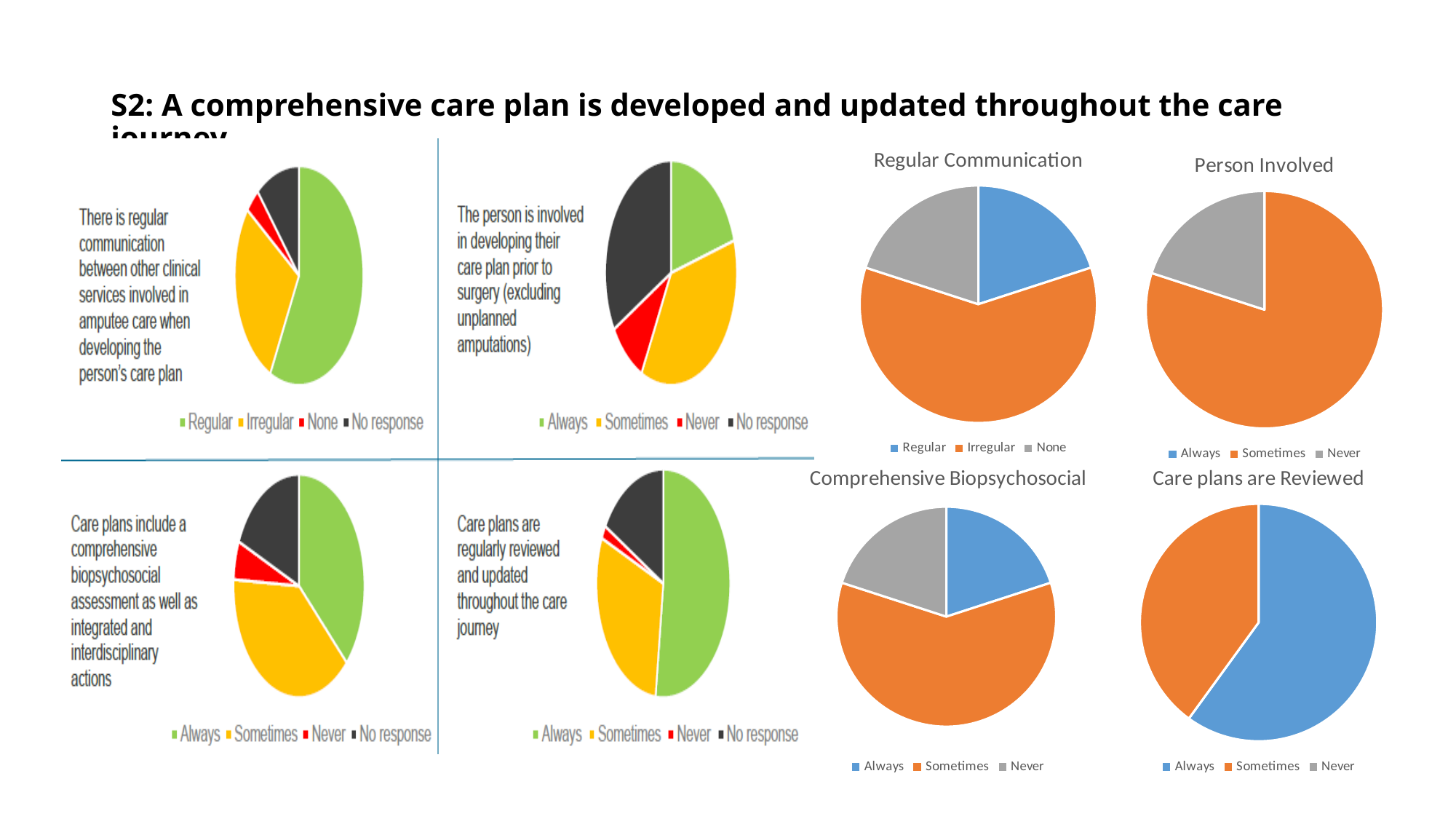
How many categories does the legend of the top-right pie chart about the person being involved in developing their care plan list? 4 What type of chart is the "Regular Communication" chart? Pie chart In the top-left pie chart about regular communication between clinical services, which category has the largest slice? Regular In the "Comprehensive Biopsychosocial" pie chart, which category has the largest slice? Sometimes In the "Regular Communication" pie chart, which category has the largest slice? Irregular In the top-left pie chart about regular communication between clinical services, which category has the smallest slice? None In the bottom-left pie chart about comprehensive biopsychosocial assessment, which category has the smallest slice? Never How many categories does the legend of the "Care plans are Reviewed" chart list? 3 In the "Person Involved" pie chart, which slice is larger, Sometimes or Never? Sometimes In the "Care plans are Reviewed" pie chart, which slice is larger, Always or Sometimes? Always